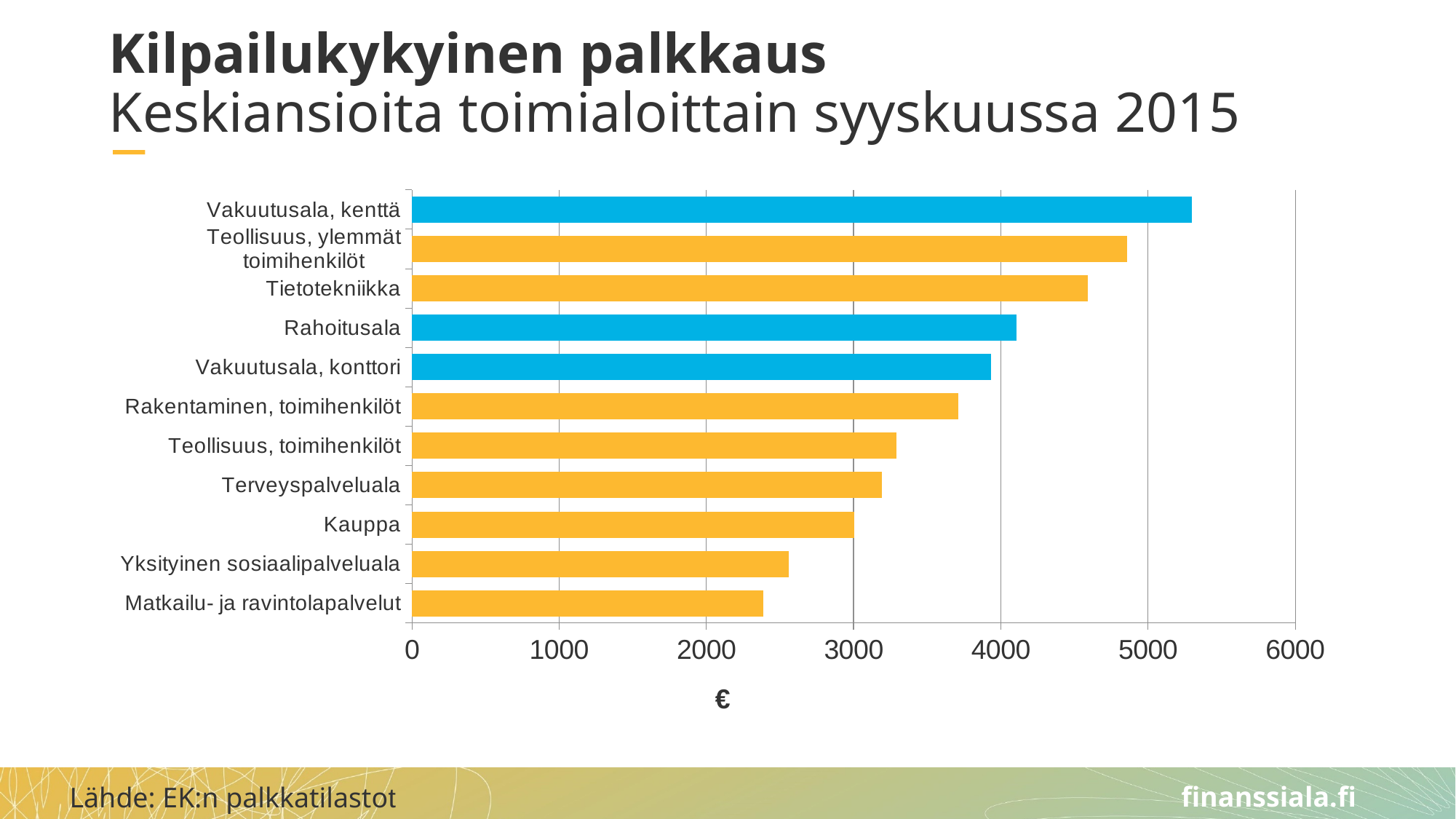
Is the value for Vakuutusala, kenttä greater or less than 5000? greater How many categories (industries) are plotted in the chart? 11 Is the value for Tietotekniikka greater or less than 4000? greater What kind of chart is shown on the slide? bar chart Is the value for Vakuutusala, konttori greater or less than 4000? less Which category has the highest value in the chart? Vakuutusala, kenttä Which is larger, the value for Teollisuus, ylemmät toimihenkilöt or the value for Tietotekniikka? Teollisuus, ylemmät toimihenkilöt Which is larger, the value for Rahoitusala or the value for Rakentaminen, toimihenkilöt? Rahoitusala What unit is shown as the label of the horizontal axis? € Which category has the lowest value in the chart? Matkailu- ja ravintolapalvelut